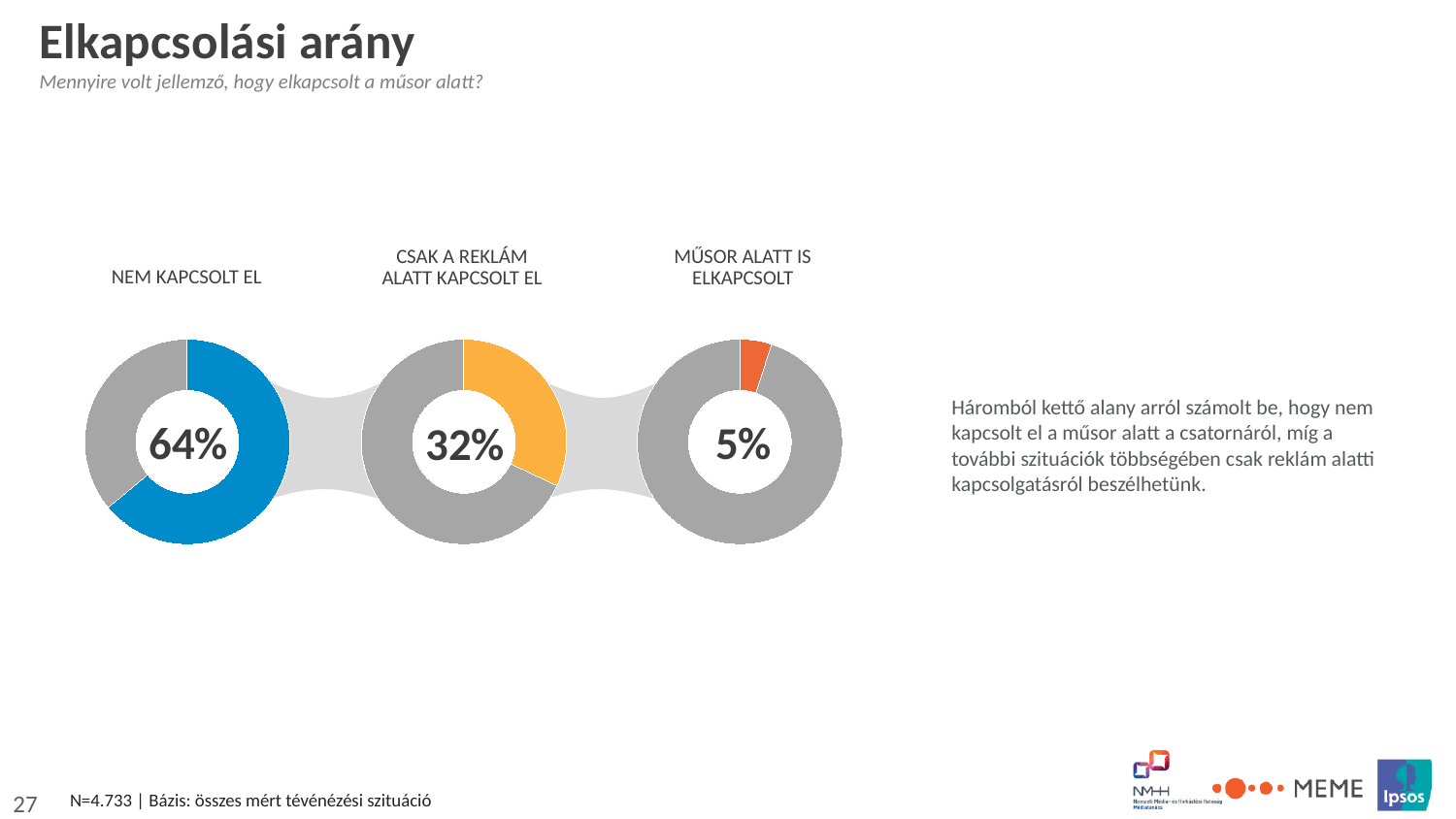
What is the title of the slide containing the donut charts? Elkapcsolási arány Which of the three donut charts shows the lowest value? MŰSOR ALATT IS ELKAPCSOLT Which is larger: the value in the 'CSAK A REKLÁM ALATT KAPCSOLT EL' chart or the value in the 'MŰSOR ALATT IS ELKAPCSOLT' chart? CSAK A REKLÁM ALATT KAPCSOLT EL What is the difference between the values in the 'NEM KAPCSOLT EL' and 'CSAK A REKLÁM ALATT KAPCSOLT EL' donut charts? 32% What value is shown in the 'CSAK A REKLÁM ALATT KAPCSOLT EL' donut chart? 32% What colour is the highlighted segment in the 'NEM KAPCSOLT EL' donut chart? Blue How many donut charts are shown on the slide? 3 What value is shown in the 'MŰSOR ALATT IS ELKAPCSOLT' donut chart? 5% What value is shown in the 'NEM KAPCSOLT EL' donut chart? 64% What is the difference between the values in the 'CSAK A REKLÁM ALATT KAPCSOLT EL' and 'MŰSOR ALATT IS ELKAPCSOLT' donut charts? 27% Which of the three donut charts shows the highest value? NEM KAPCSOLT EL What type of chart is used to display the values on this slide? Donut chart